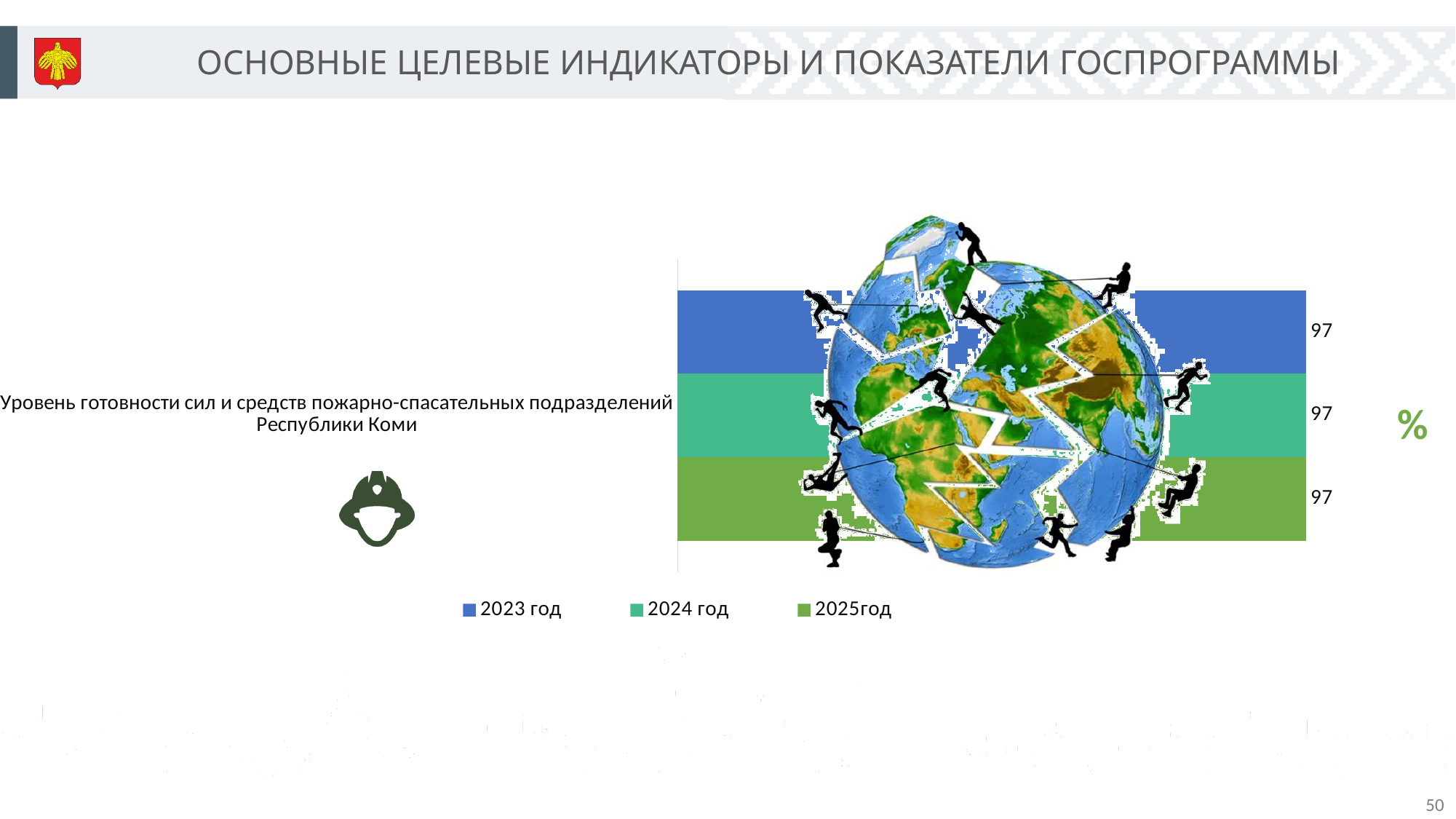
What category label is shown to the left of the bars? Уровень готовности сил и средств пожарно-спасательных подразделений Республики Коми What is the value for 2023 год in the chart? 97 Do the values change from 2023 год to 2025год, or stay the same? stay the same What kind of chart is shown on the slide? bar chart What is the value for 2024 год in the chart? 97 What is the difference between the values for 2023 год and 2025год? 0 How many series does the legend list? 3 What is the value for 2025год in the chart? 97 Which series is shown in blue in the legend? 2023 год How many bars are plotted in the chart? 3